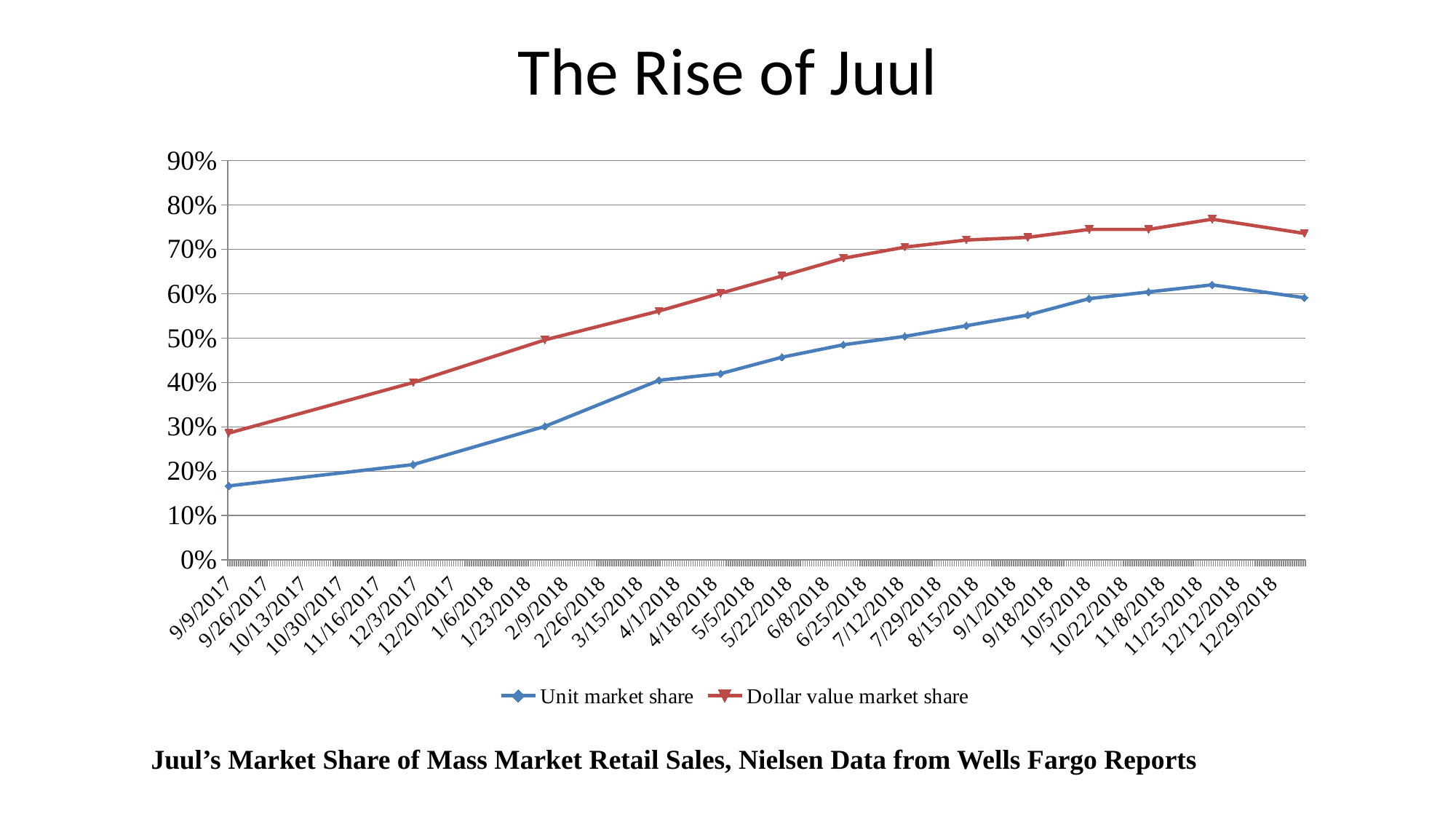
How many series does the legend list? 2 Is the first value for Unit market share (9/9/2017) greater or less than 20%? less Do the values for Unit market share generally rise or fall from 9/9/2017 to 12/29/2018? Rise How many date labels are shown on the x axis? 29 Do the values for Dollar value market share generally rise or fall across the chart? Rise What is the title of the slide? The Rise of Juul Which series is higher throughout the chart, Unit market share or Dollar value market share? Dollar value market share What kind of chart is shown on the slide? Line chart Is the last value for Unit market share (12/29/2018) greater or less than 50%? greater Is the first value for Dollar value market share (9/9/2017) greater or less than 20%? greater What are the two series named in the legend? Unit market share and Dollar value market share